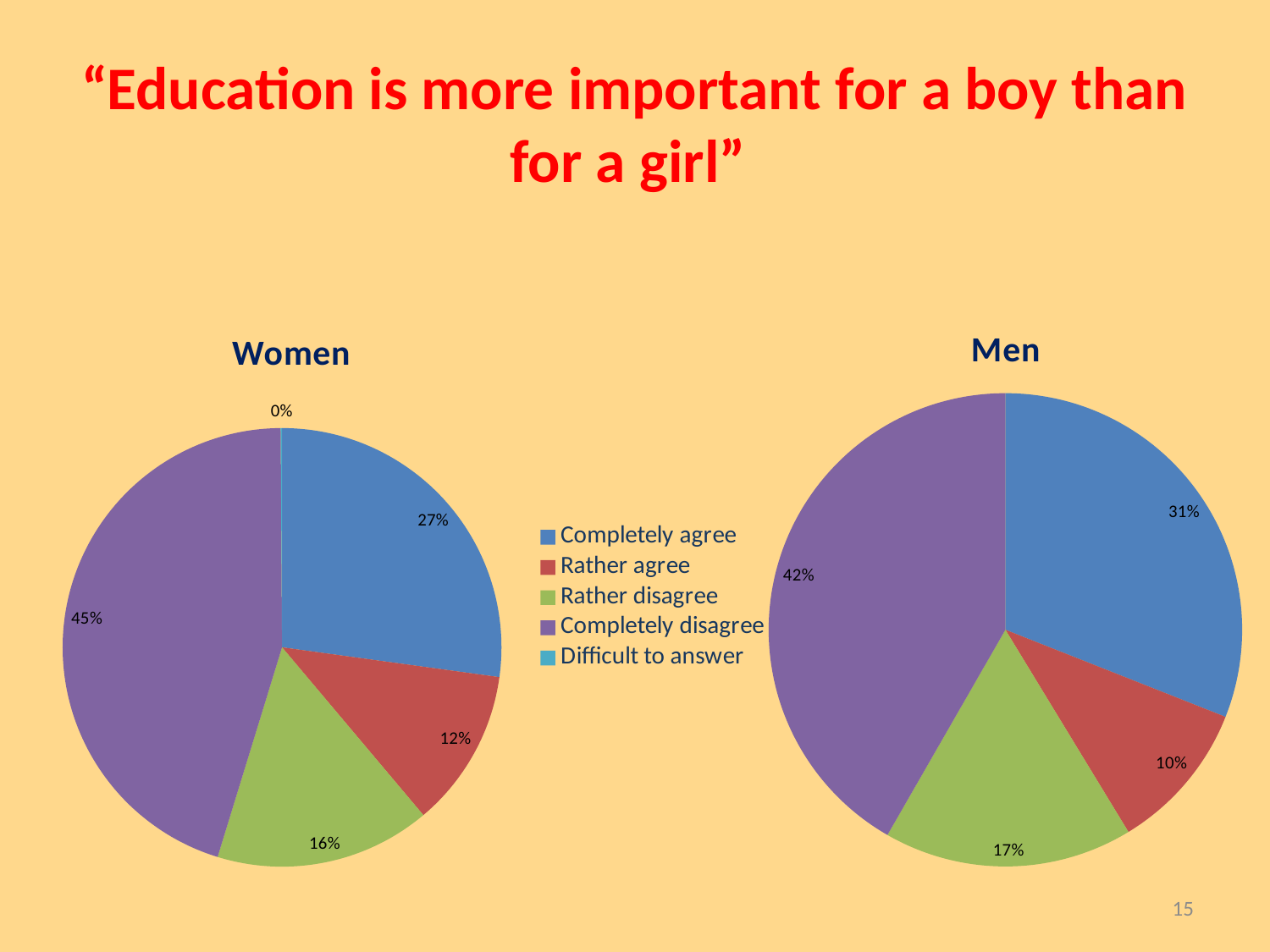
Which colour represents Rather disagree in the charts? Green In the Men chart, what percentage of respondents completely agree? 31% In the Women chart, what percentage of respondents completely disagree? 45% What is the difference between the Completely disagree shares in the Women chart and the Men chart? 3% In the Women chart, what percentage is shown for Difficult to answer? 0% In the Men chart, which response has the smallest share among the labelled slices? Rather agree In the Women chart, what percentage of respondents rather agree? 12% Which chart shows a larger share for Completely agree, Women or Men? Men In the Men chart, what percentage of respondents rather disagree? 17% In the Women chart, which response has the largest share? Completely disagree What type of chart is used for the Women and Men data? Pie chart How many entries does the legend list? 5